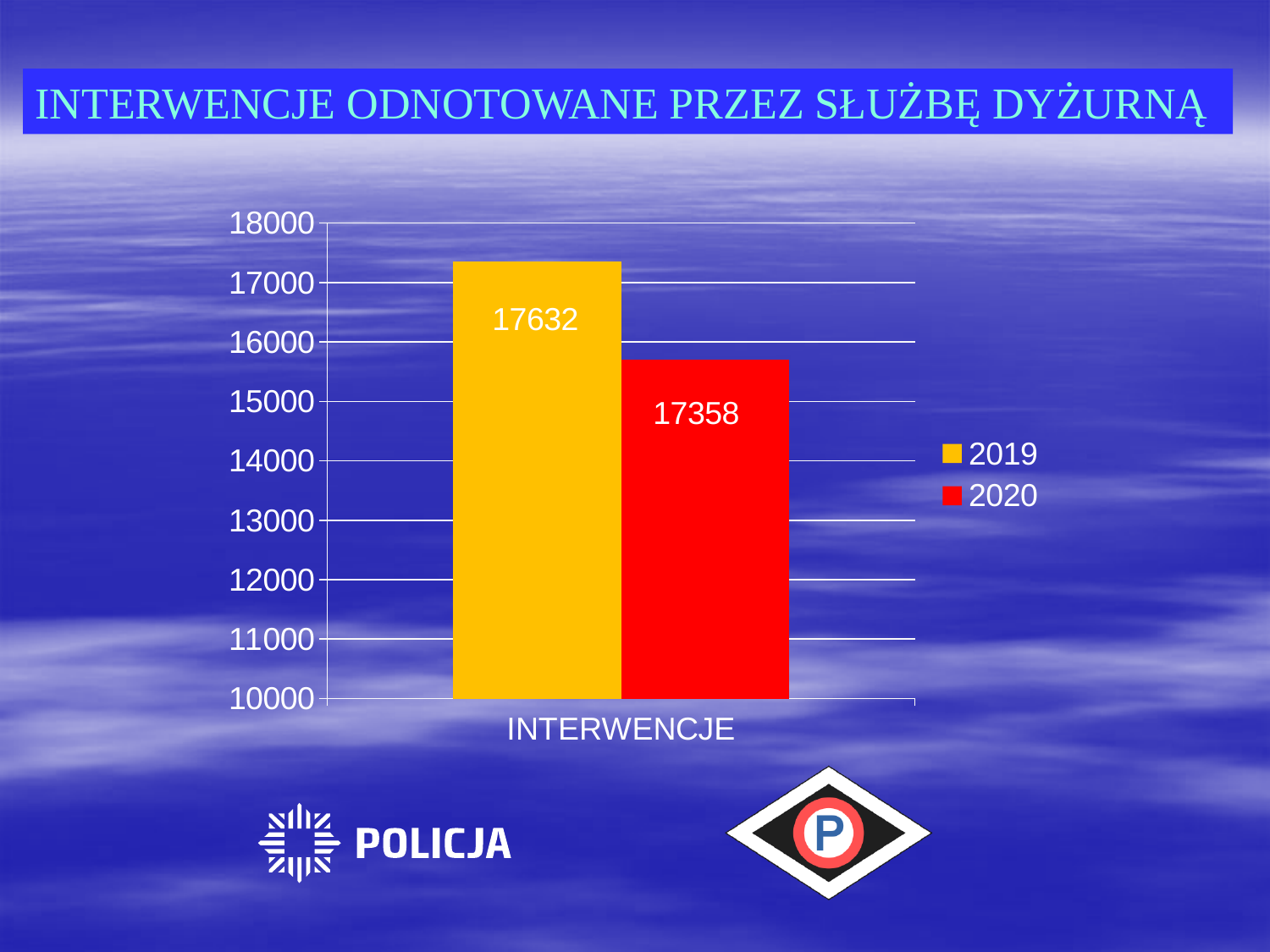
How many series does the legend list? 2 What is the title of the chart on the slide? INTERWENCJE ODNOTOWANE PRZEZ SŁUŻBĘ DYŻURNĄ What kind of chart is shown on the slide? bar chart Which series has the lowest value in the chart? 2020 How many categories are shown on the x axis? 1 What is the value for 2020 in the INTERWENCJE chart? 17358 What is the label of the category on the x axis? INTERWENCJE Which year has the higher number of interventions, 2019 or 2020? 2019 What colour is the bar for 2020? red What is the difference between the 2019 and 2020 values? 274 What is the value for 2019 in the INTERWENCJE chart? 17632